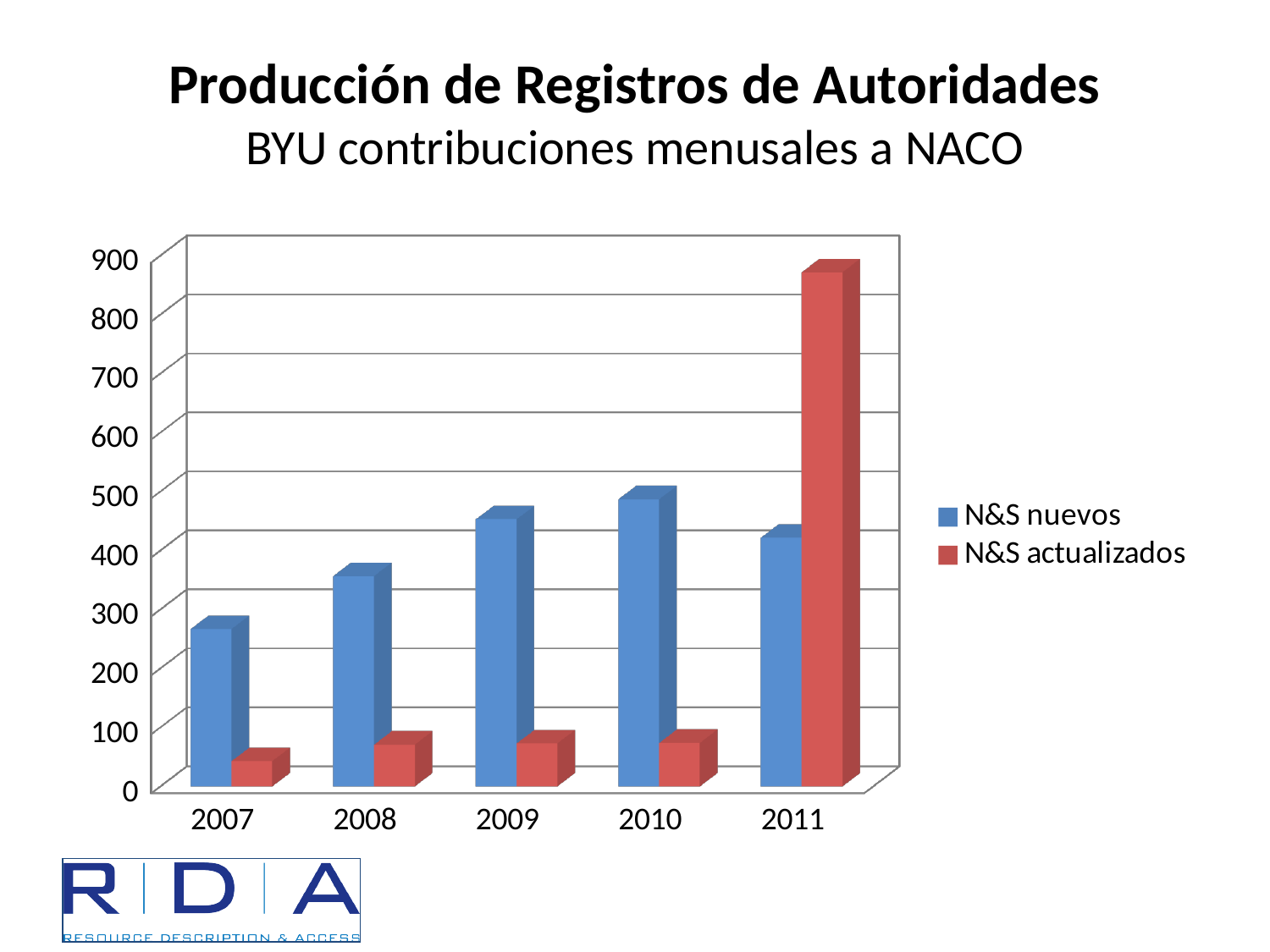
In 2011, which series has the larger value, N&S nuevos or N&S actualizados? N&S actualizados Do the values for N&S nuevos rise or fall from 2007 to 2010? rise How many years are shown on the x axis of the chart? 5 Which year has the lowest value for N&S actualizados? 2007 Which year has the lowest value for N&S nuevos? 2007 Which year has the highest value for N&S nuevos? 2010 What kind of chart is shown on the slide? bar chart Is the value for N&S nuevos in 2007 greater or less than 300? less Is the value for N&S actualizados in 2007 greater or less than 100? less Which year has the highest value for N&S actualizados? 2011 How many series does the chart's legend list? 2 Is the value for N&S actualizados in 2011 greater or less than 800? greater